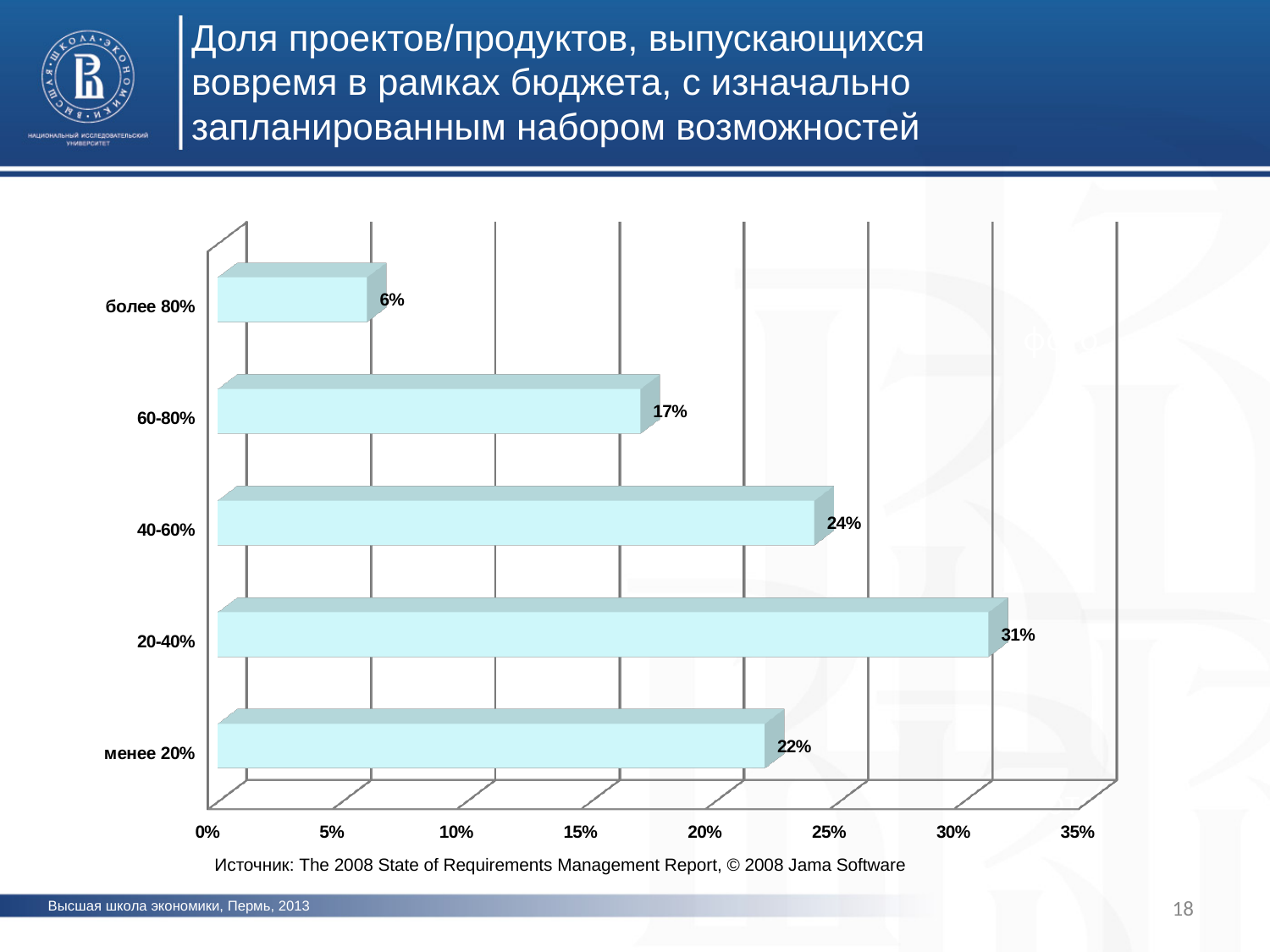
What is the difference between the values for "20-40%" and "менее 20%"? 9% Which is larger, the value for "менее 20%" or the value for "60-80%"? менее 20% Which category has the highest value? 20-40% What is the value for the "40-60%" category? 24% Is the value for "20-40%" greater or less than 30%? greater What is the difference between the values for "40-60%" and "60-80%"? 7% Which category has the lowest value? более 80% How many categories are shown in the chart? 5 What is the value for the "20-40%" category? 31% What is the value for the "более 80%" category? 6% What kind of chart is shown on the slide? bar chart What is the maximum value shown on the horizontal axis? 35%